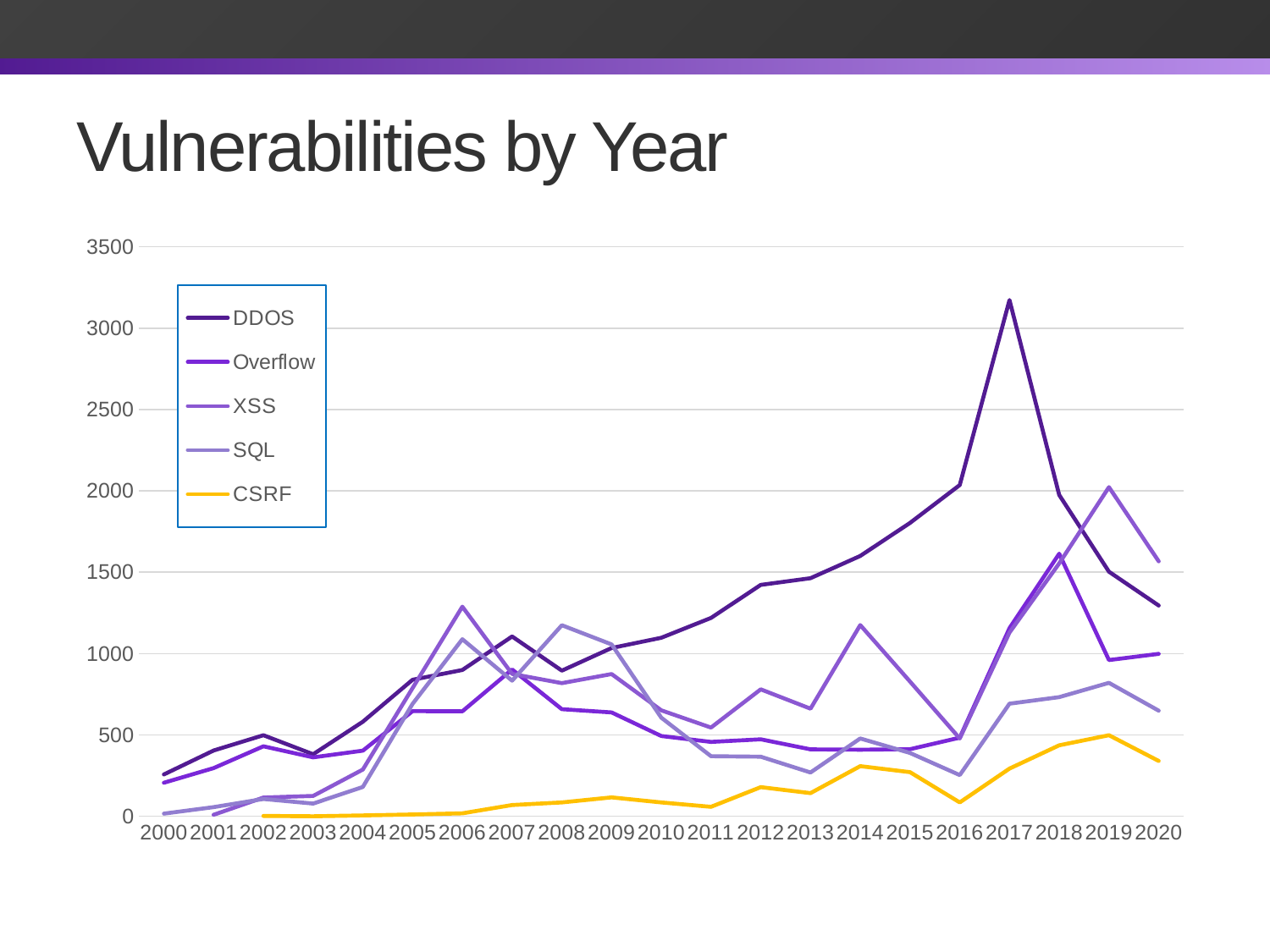
What is the title of the chart? Vulnerabilities by Year What kind of chart is shown on the slide? line chart Is the value for XSS in 2019 greater or less than 1500? greater Which is larger in 2019, the value for XSS or the value for DDOS? XSS How many years are shown along the x axis? 21 Which series has the lowest value in 2020? CSRF How many series does the legend list? 5 In which year does the DDOS line reach its highest value? 2017 Does the DDOS line rise or fall from 2017 to 2020? fall Is the value for DDOS in 2017 greater or less than 3000? greater Is the value for SQL in 2020 greater or less than 500? greater